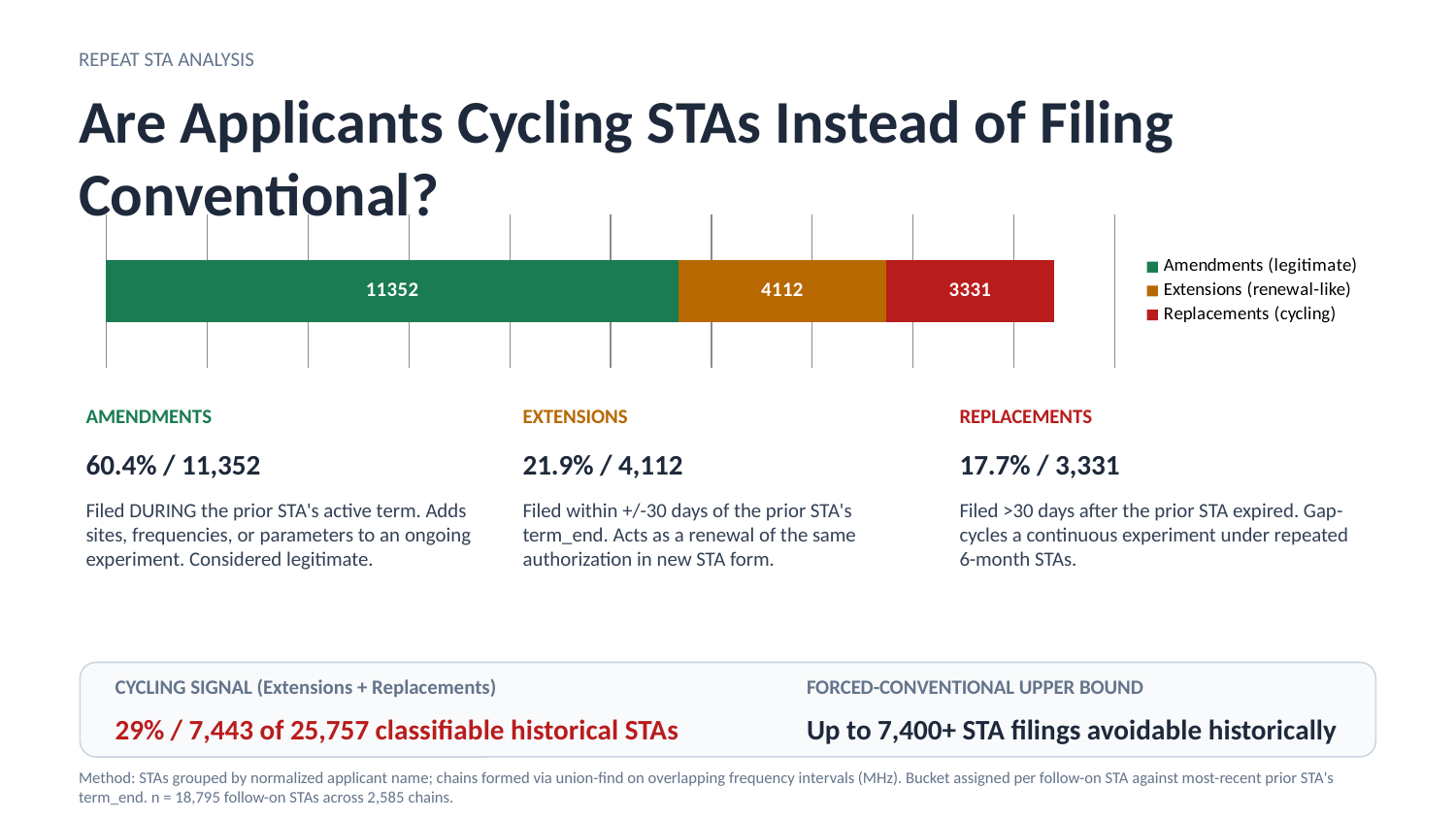
What colour is the Replacements (cycling) segment in the bar? red What is the total of all three segments in the stacked bar? 18795 What is the value of the Amendments (legitimate) segment in the bar? 11352 Which series has the smallest segment in the bar? Replacements (cycling) What is the difference between the Extensions (renewal-like) and Replacements (cycling) values? 781 What is the difference between the Amendments (legitimate) and Extensions (renewal-like) values? 7240 How many series does the chart legend list? 3 Which series has the largest segment in the bar? Amendments (legitimate) What is the value of the Replacements (cycling) segment in the bar? 3331 What is the value of the Extensions (renewal-like) segment in the bar? 4112 What kind of chart is shown on the slide? stacked bar chart Which is larger, the Extensions (renewal-like) segment or the Replacements (cycling) segment? Extensions (renewal-like)